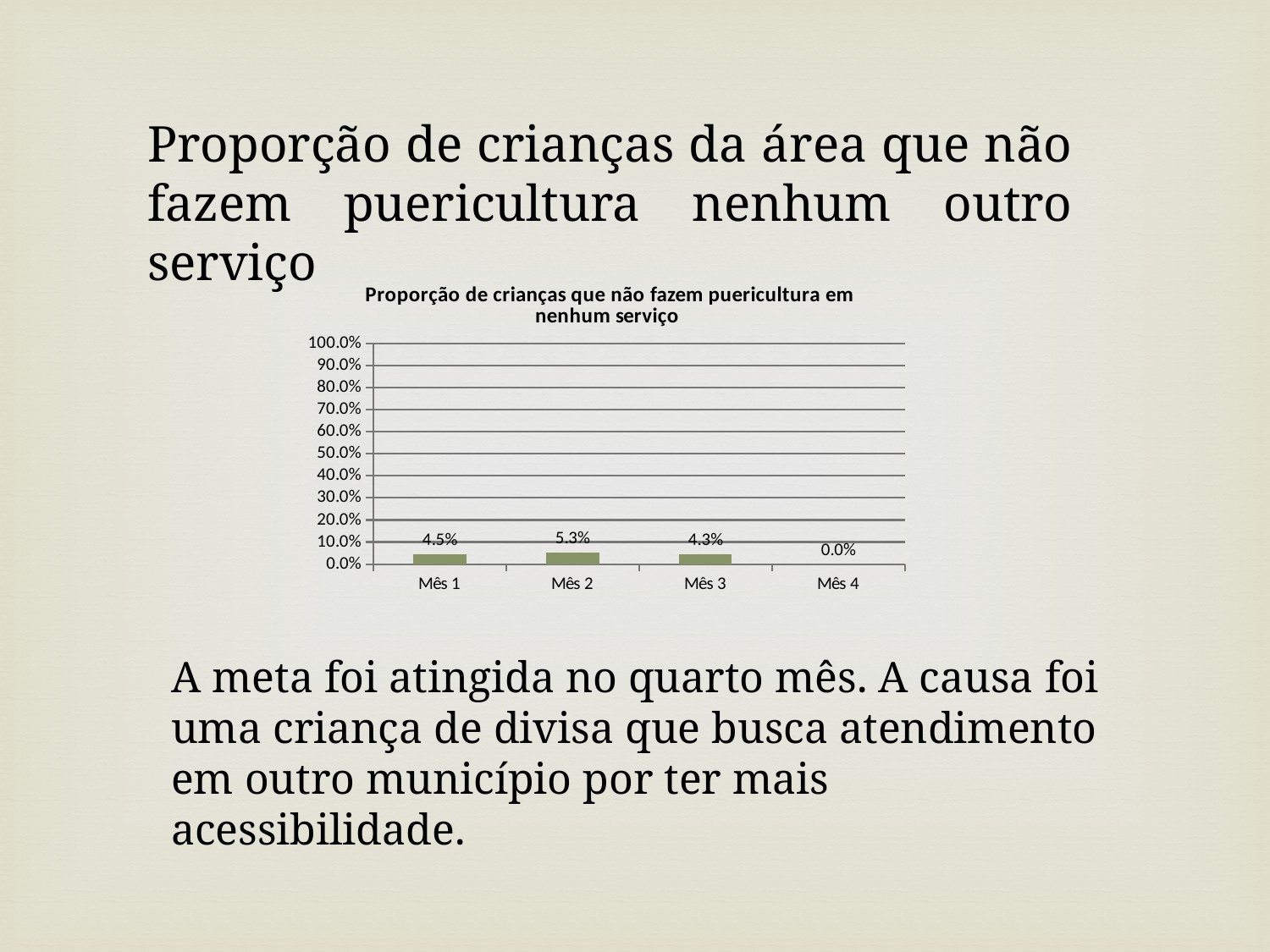
What is the value for Mês 3? 4.3% Is the value for Mês 2 greater or less than 10.0%? less What is the value for Mês 2? 5.3% What is the difference between the values for Mês 2 and Mês 3? 1.0% What is the value for Mês 4? 0.0% Which month has the lowest value? Mês 4 Which month has the highest value? Mês 2 How many months are shown on the x axis? 4 What kind of chart is shown on the slide? bar chart What is the value for Mês 1? 4.5% What is the title of the chart? Proporção de crianças que não fazem puericultura em nenhum serviço Which is larger, the value for Mês 1 or the value for Mês 2? Mês 2